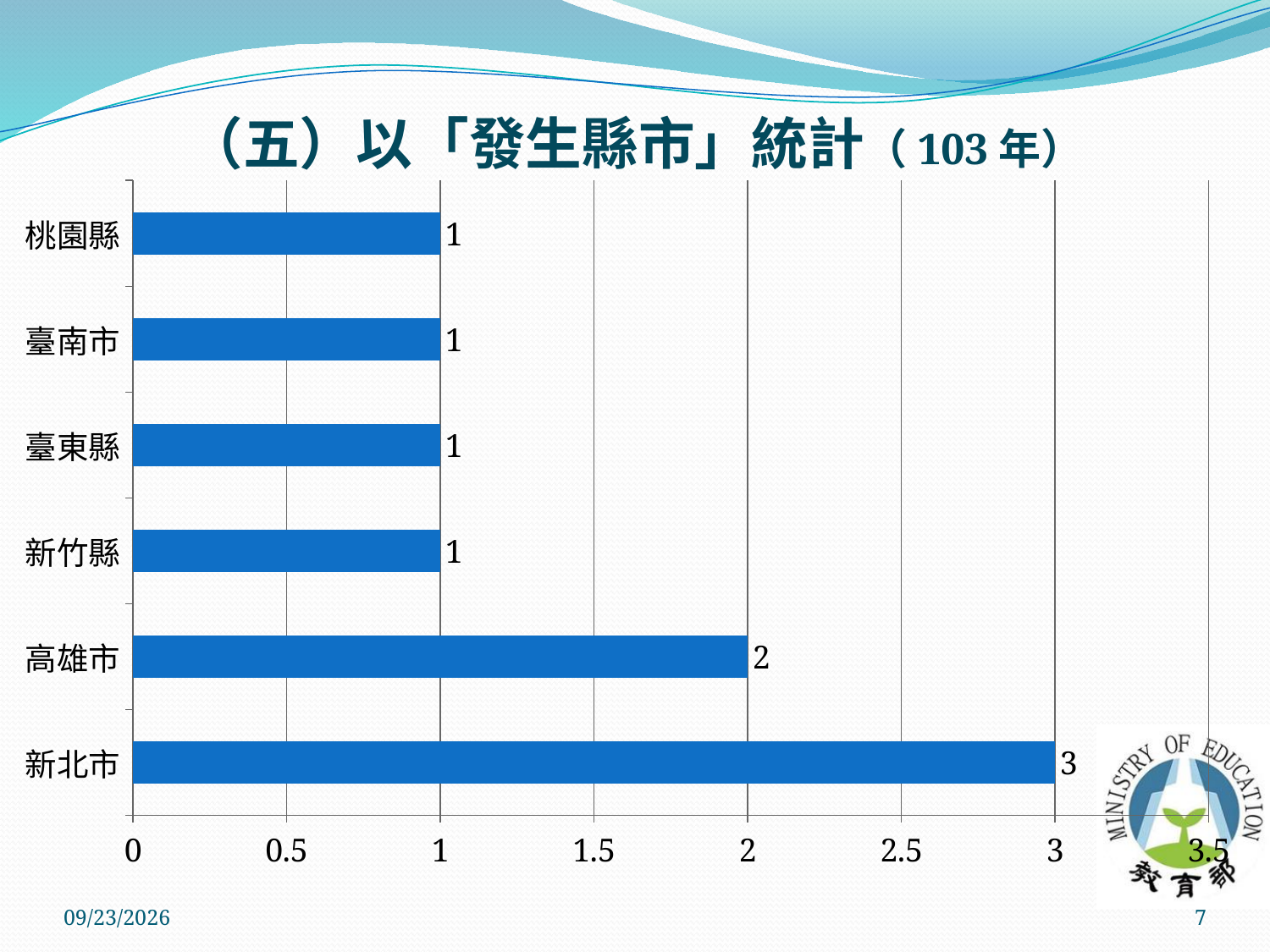
What is the difference between the values for 高雄市 and 新竹縣? 1 Which category has the highest value? 新北市 Which is larger, the value for 高雄市 or the value for 臺南市? 高雄市 What is the value for 高雄市? 2 What is the title of the chart? （五）以「發生縣市」統計（103年） What is the value for 新北市? 3 How many categories are shown in the chart? 6 What is the difference between the values for 新北市 and 高雄市? 1 Is the value for 新北市 greater or less than 2.5? greater What kind of chart is shown on the slide? bar chart What is the value for 桃園縣? 1 How many categories have a value of 1? 4